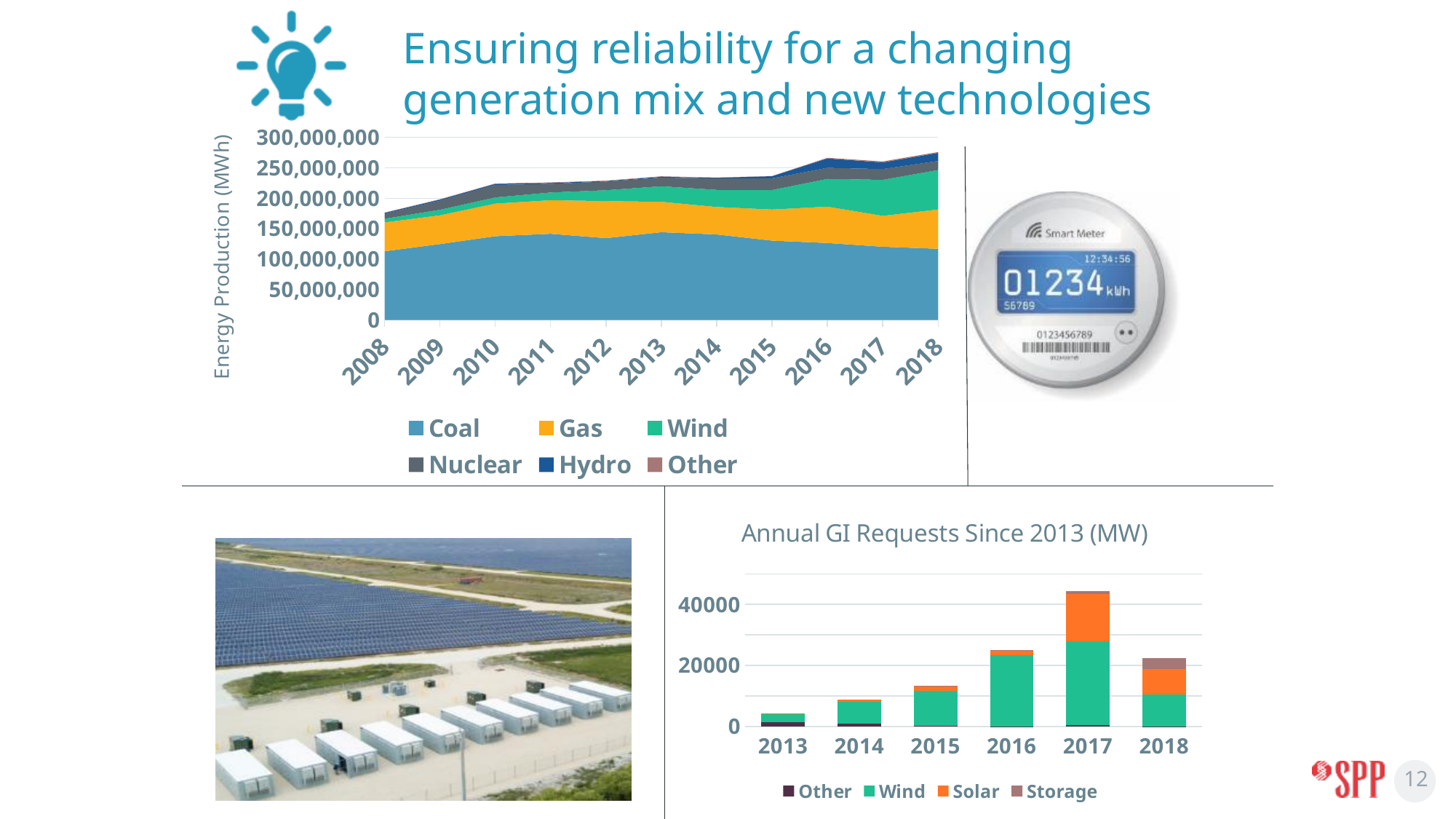
In the 'Annual GI Requests Since 2013 (MW)' chart, is the total for 2015 greater or less than 20000? less How many series does the legend of the 'Annual GI Requests Since 2013 (MW)' chart list? 4 How many series does the legend of the Energy Production (MWh) chart list? 6 In the Energy Production (MWh) chart, which series accounts for the largest share of production across the years? Coal What kind of chart is the top-left chart showing Energy Production (MWh)? stacked area chart In the 'Annual GI Requests Since 2013 (MW)' chart, is the total for 2017 greater or less than 40000? greater In the 'Annual GI Requests Since 2013 (MW)' chart, which year has the highest total? 2017 In the Energy Production (MWh) chart, is the total production in 2016 greater or less than 250,000,000? greater How many years are shown on the x axis of the 'Annual GI Requests Since 2013 (MW)' chart? 6 What kind of chart is the 'Annual GI Requests Since 2013 (MW)' chart? stacked bar chart In the 'Annual GI Requests Since 2013 (MW)' chart, which year has the lowest total? 2013 How many years are shown on the x axis of the Energy Production (MWh) chart? 11